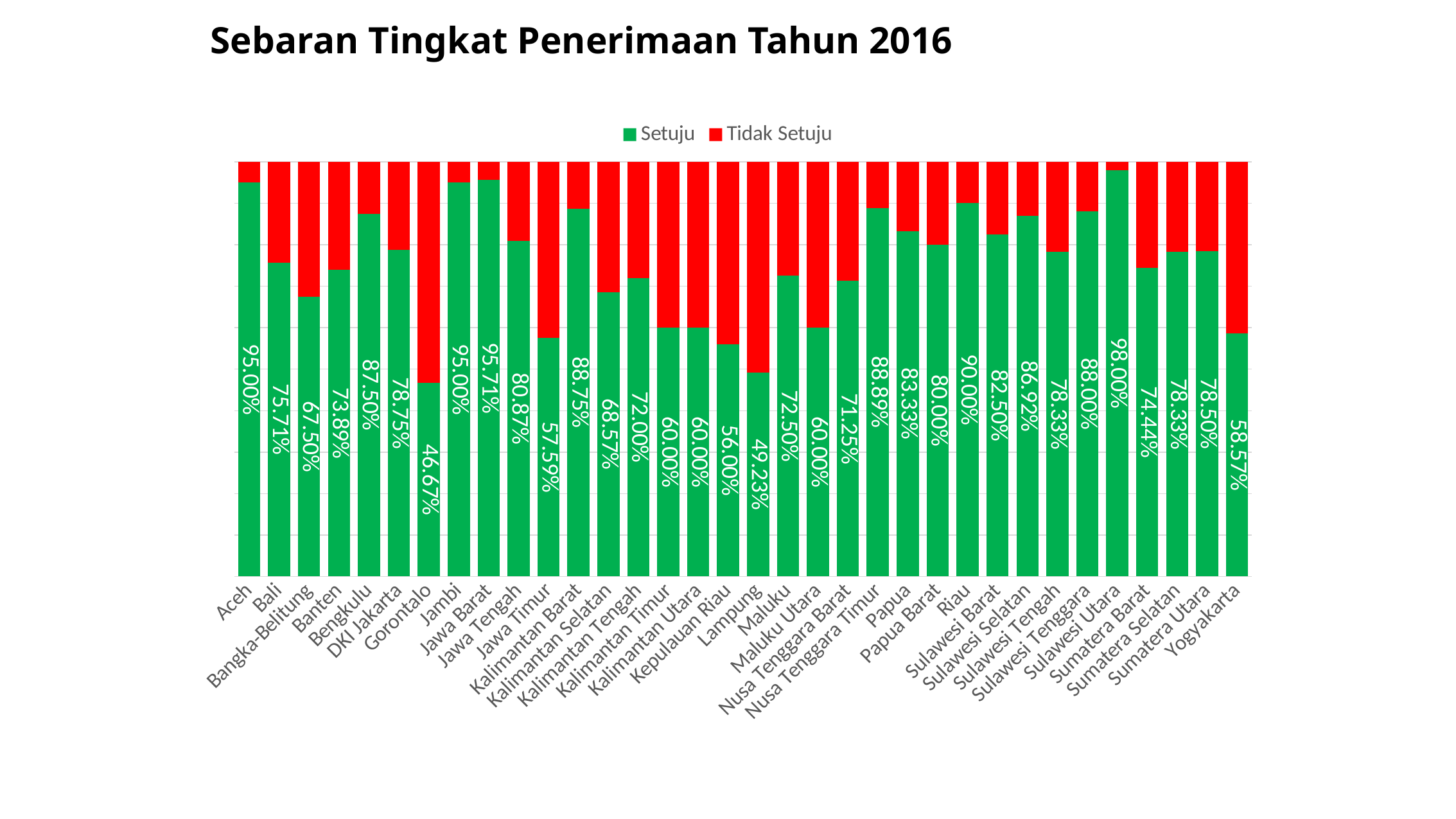
What kind of chart is shown on the slide? Stacked bar chart How many provinces are shown on the x axis? 34 How many series does the legend list? 2 What is the Setuju value for Yogyakarta? 58.57% What is the difference between the Setuju values for Jawa Barat and Jawa Timur? 38.12% Which has a larger Setuju value, Riau or Papua? Riau What is the Setuju value for Gorontalo? 46.67% Which province has the lowest Setuju value? Gorontalo What is the Setuju value for Nusa Tenggara Timur? 88.89% What is the Setuju value for Sulawesi Selatan? 86.92% Which province has the highest Setuju value? Sulawesi Utara What is the title of the chart? Sebaran Tingkat Penerimaan Tahun 2016